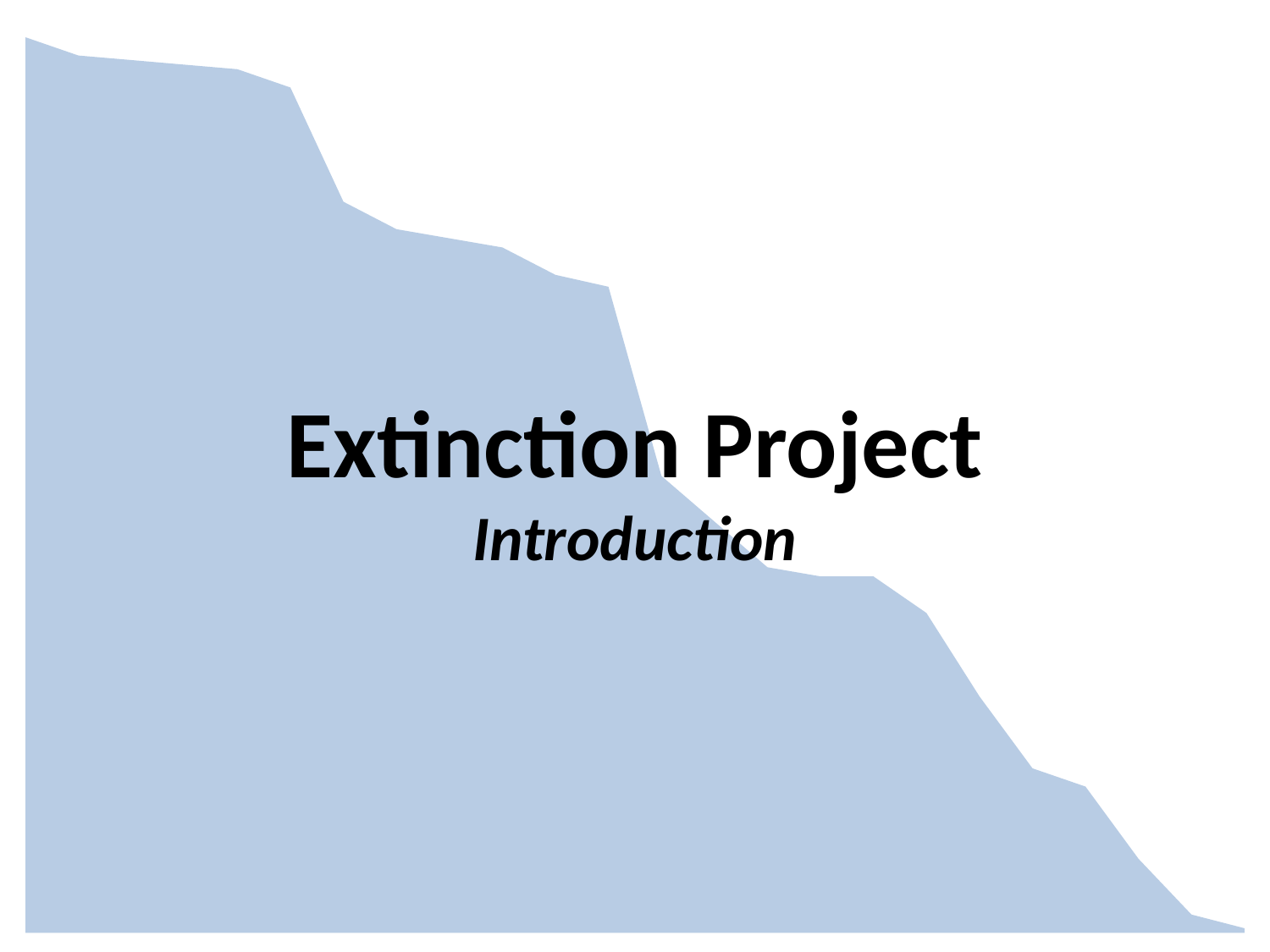
What colour is the filled area of the chart? Light blue Does the chart display a legend? No Do the values in the area chart rise or fall from left to right along the x axis? Fall What kind of chart is shown on the slide? Area chart